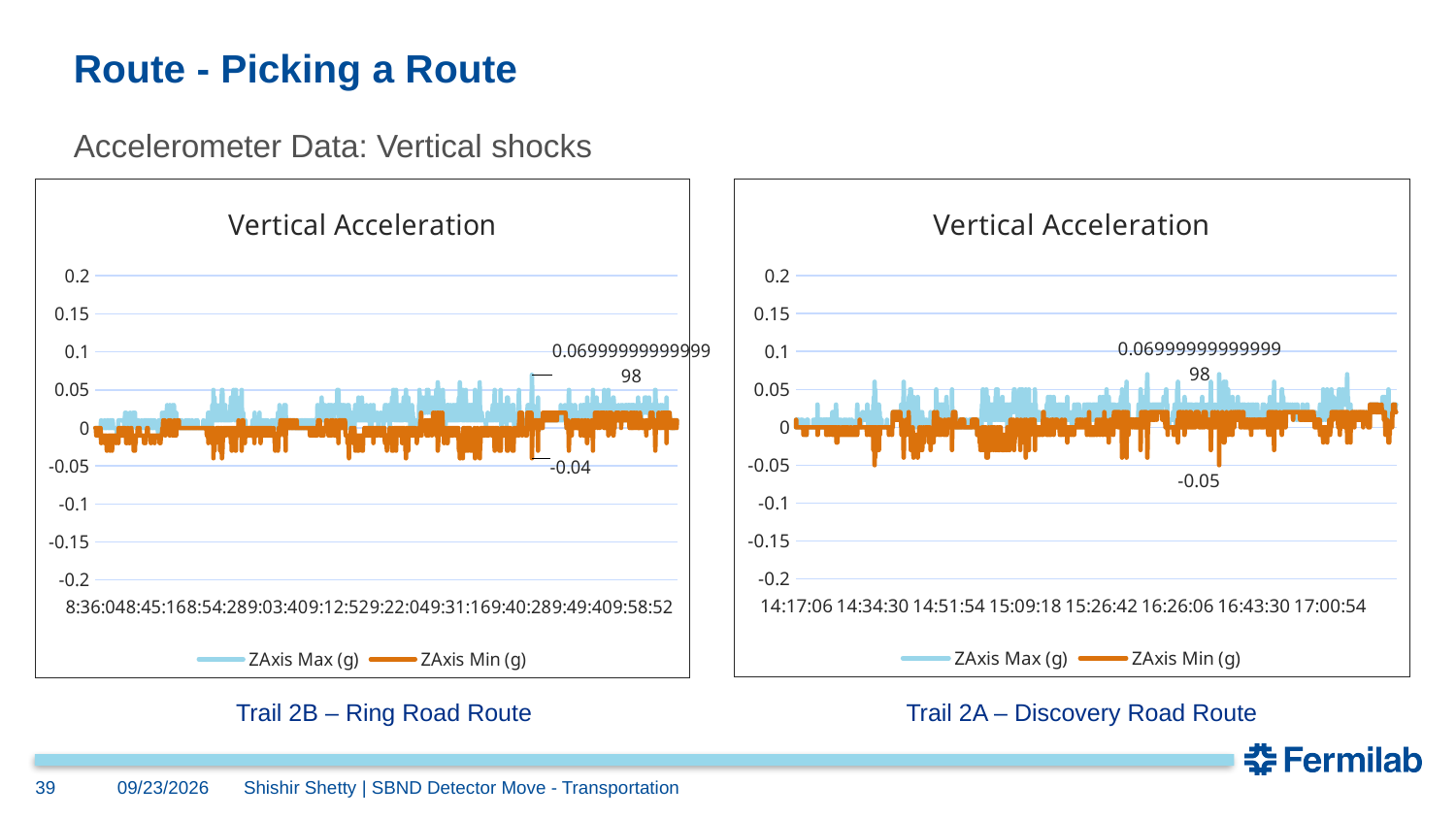
How many time labels are shown on the x axis of the Trail 2A – Discovery Road Route chart on the right? 8 What kind of chart is the Trail 2B – Ring Road Route chart on the left? Line chart In the Trail 2B – Ring Road Route chart on the left, what is the labeled maximum value of the ZAxis Max (g) series? 0.0699999999999998 In the Trail 2A – Discovery Road Route chart on the right, what is the labeled maximum value of the ZAxis Max (g) series? 0.0699999999999998 Which chart has the lower labeled ZAxis Min (g) value, Trail 2B – Ring Road Route or Trail 2A – Discovery Road Route? Trail 2A – Discovery Road Route How many series does the legend list in the Trail 2A – Discovery Road Route chart on the right? 2 In the Trail 2A – Discovery Road Route chart on the right, what is the labeled minimum value of the ZAxis Min (g) series? -0.05 In the Trail 2A – Discovery Road Route chart on the right, is the labeled minimum of the ZAxis Min (g) series greater or less than -0.1? greater In the Trail 2B – Ring Road Route chart on the left, is the labeled peak of the ZAxis Max (g) series greater or less than 0.1? less What are the two legend entries in the Trail 2B – Ring Road Route chart on the left? ZAxis Max (g) and ZAxis Min (g) In the Trail 2B – Ring Road Route chart on the left, what is the labeled minimum value of the ZAxis Min (g) series? -0.04 What is the title of the chart on the right (Trail 2A – Discovery Road Route)? Vertical Acceleration